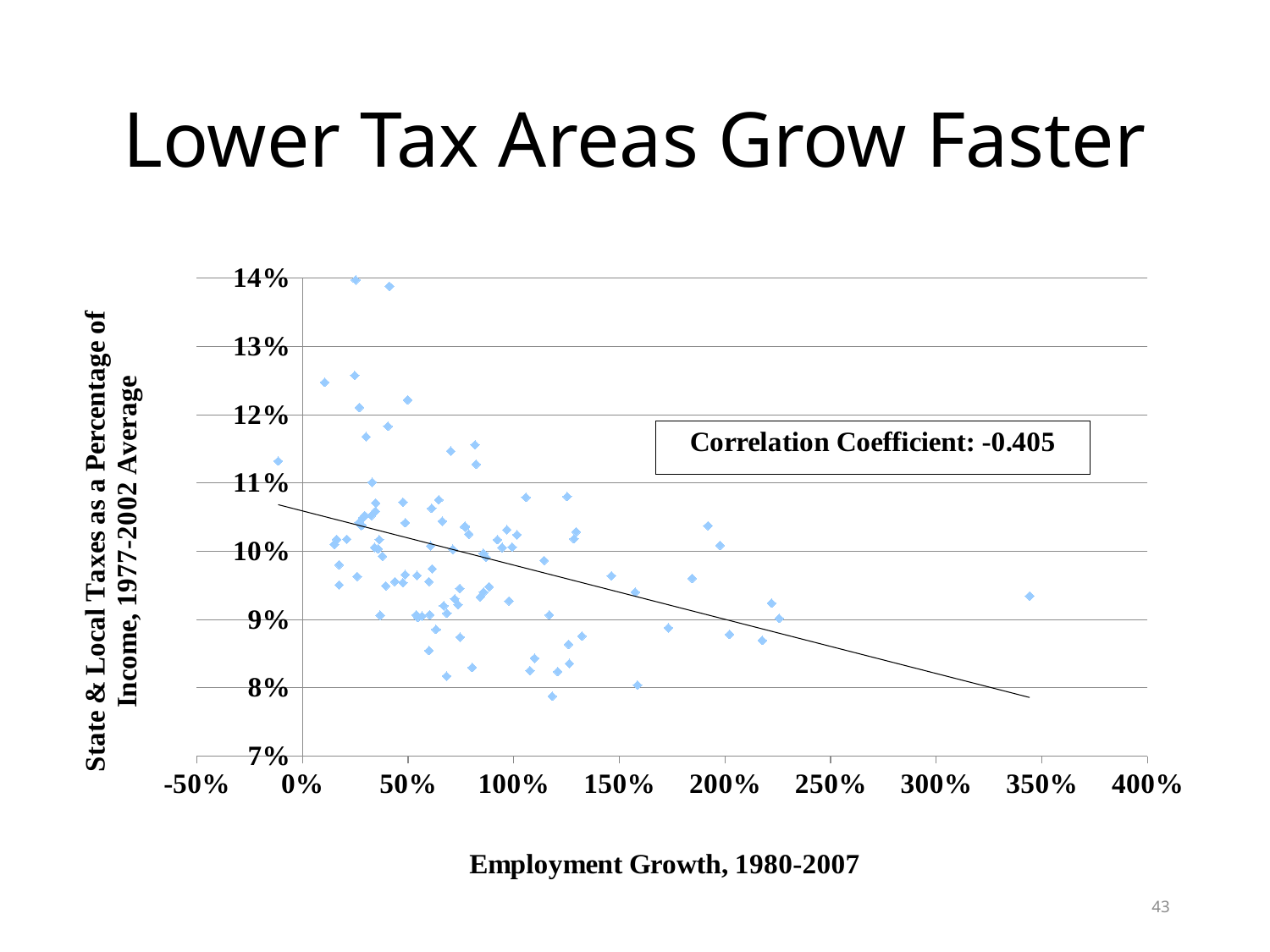
Is the tax percentage for the point with the highest employment growth greater or less than 9%? greater Is the employment growth for the lowest point on the chart greater or less than 200%? less Is the tax percentage for the point with the highest employment growth (near 350%) greater or less than 10%? less What is the highest value shown on the y axis? 14% What is the label of the x axis? Employment Growth, 1980-2007 What correlation coefficient is printed on the chart? -0.405 As employment growth increases along the x axis, does the trend line for state and local taxes rise or fall? fall What kind of chart is shown on the slide? scatter plot What is the title of the slide's chart? Lower Tax Areas Grow Faster